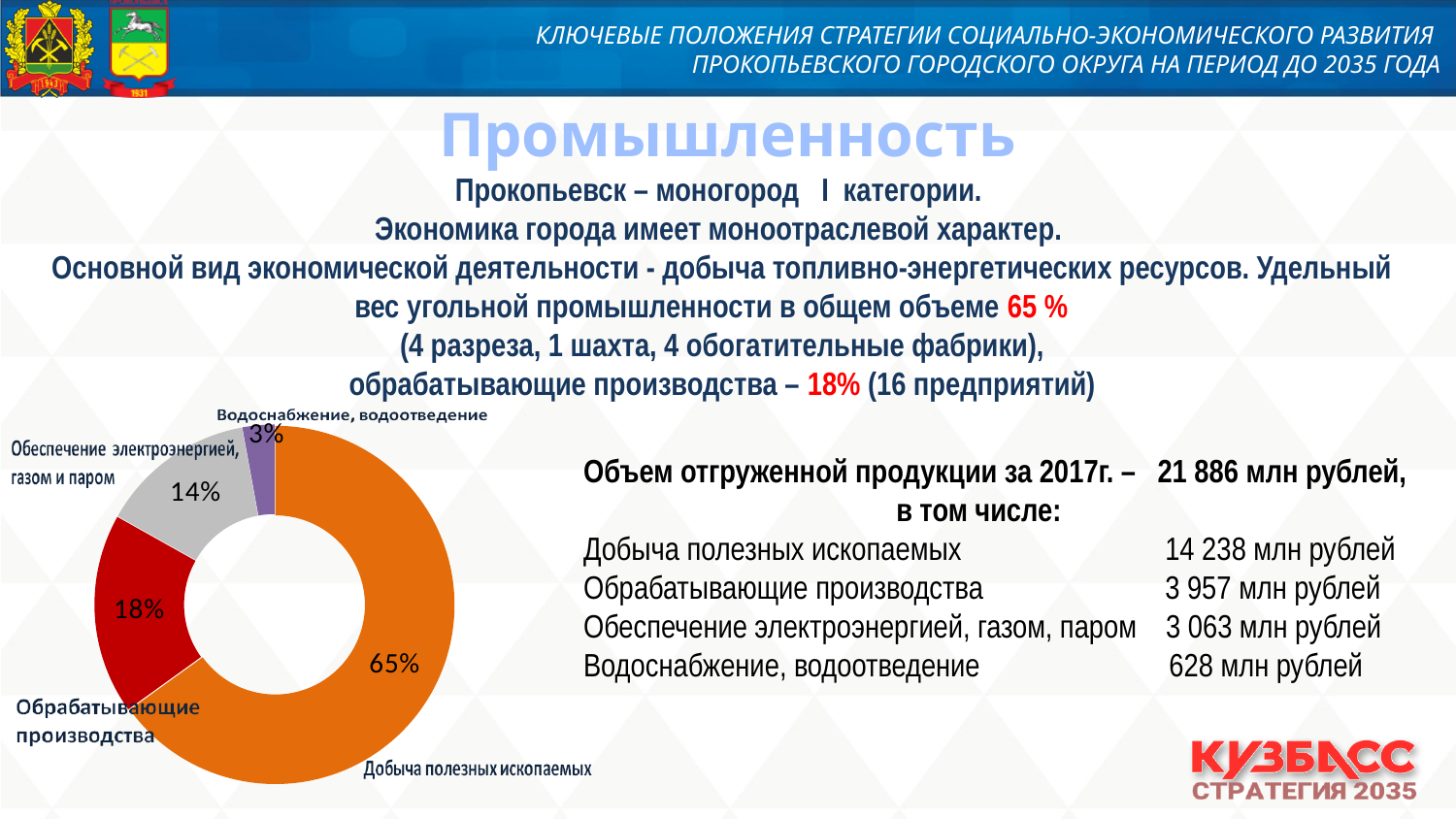
How many slices does the pie chart have? 4 Which slice is larger: "Обрабатывающие производства" or "Обеспечение электроэнергией, газом и паром"? Обрабатывающие производства What share of the pie chart is labelled "Обрабатывающие производства"? 18% What share of the pie chart is labelled "Добыча полезных ископаемых"? 65% What kind of chart is shown on the slide? Pie chart (donut) What is the difference between the "Обеспечение электроэнергией, газом и паром" slice and the "Водоснабжение, водоотведение" slice? 11 percentage points What colour is the "Добыча полезных ископаемых" slice in the pie chart? Orange What share of the pie chart is labelled "Водоснабжение, водоотведение"? 3% Which slice of the pie chart is the smallest? Водоснабжение, водоотведение By how many percentage points does the "Добыча полезных ископаемых" slice exceed the "Обрабатывающие производства" slice? 47 percentage points What share of the pie chart is labelled "Обеспечение электроэнергией, газом и паром"? 14% Which slice of the pie chart is the largest? Добыча полезных ископаемых